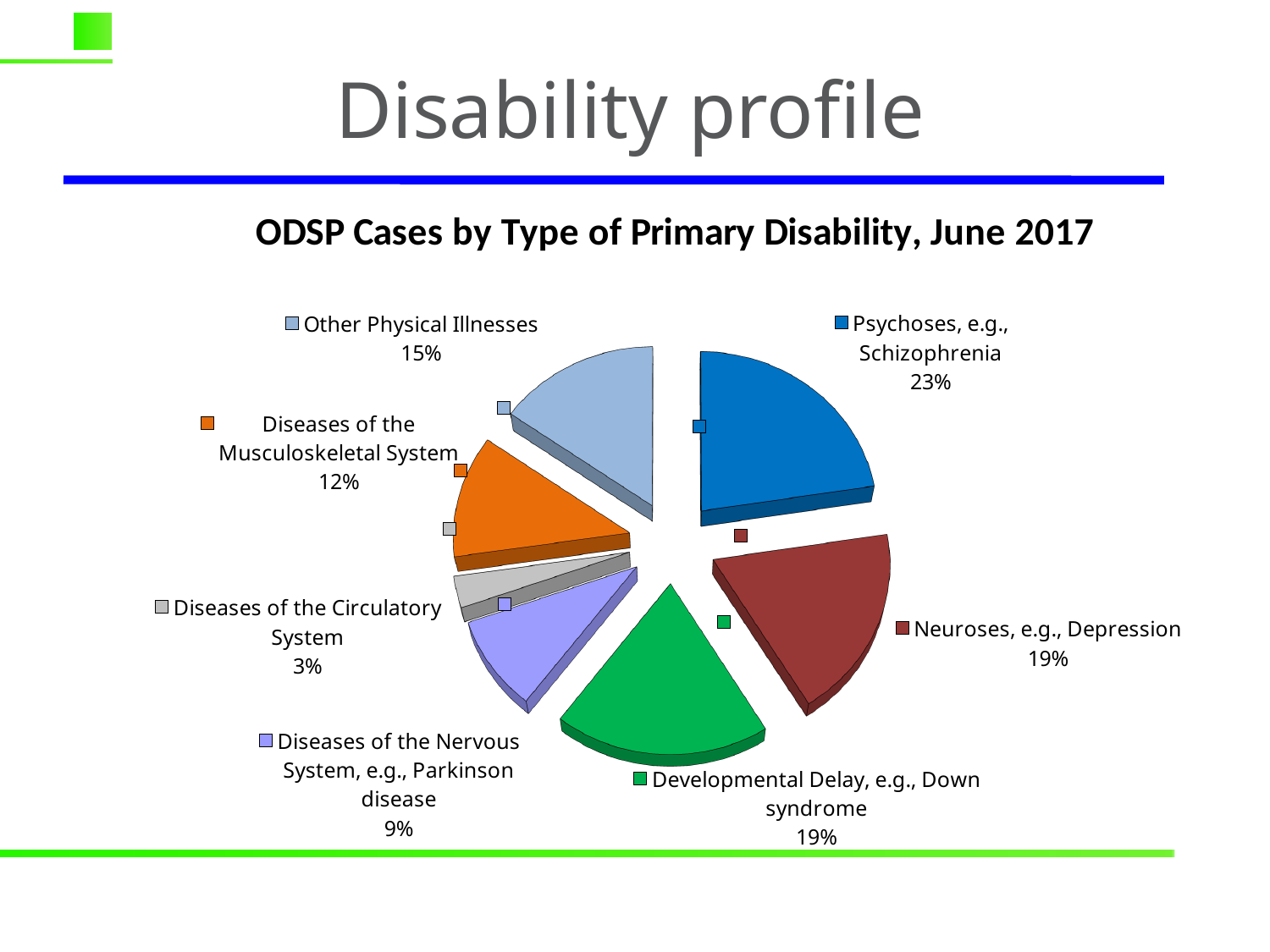
What type of chart is shown on the slide? Pie chart What is the combined share of Neuroses, e.g., Depression and Developmental Delay, e.g., Down syndrome? 38% What percentage of cases is Diseases of the Musculoskeletal System? 12% What share of ODSP cases is attributed to Psychoses, e.g., Schizophrenia? 23% What percentage of cases is Diseases of the Nervous System, e.g., Parkinson disease? 9% Which type of primary disability has the smallest share of cases? Diseases of the Circulatory System How many types of primary disability are shown in the pie chart? 7 What is the title of the chart? ODSP Cases by Type of Primary Disability, June 2017 Which type of primary disability has the largest share of cases? Psychoses, e.g., Schizophrenia What percentage of cases is Other Physical Illnesses? 15% Which has a larger share: Other Physical Illnesses or Diseases of the Musculoskeletal System? Other Physical Illnesses What is the difference in percentage points between Psychoses, e.g., Schizophrenia and Neuroses, e.g., Depression? 4 percentage points